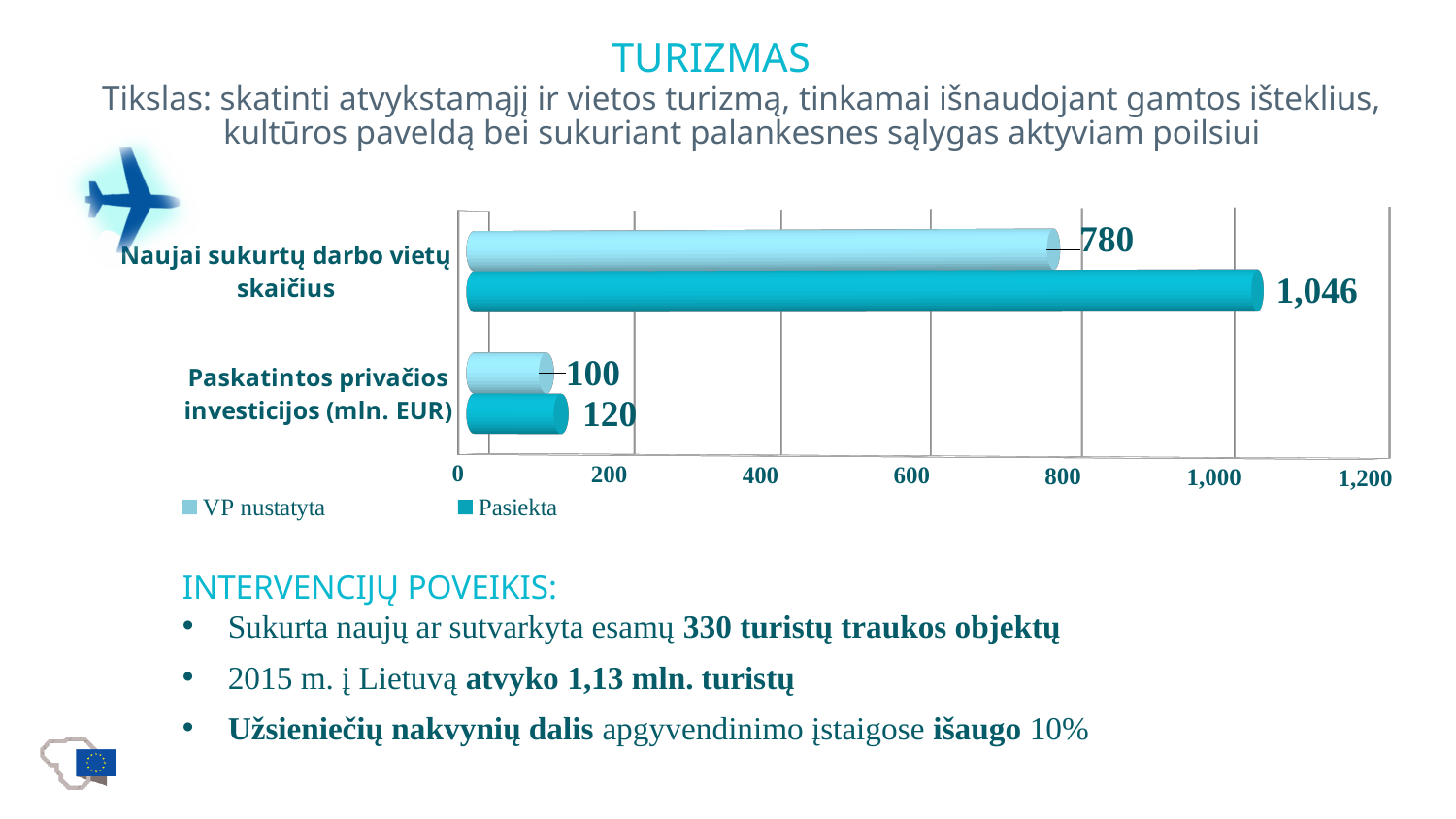
Which category has the highest 'Pasiekta' value? Naujai sukurtų darbo vietų skaičius What is the 'VP nustatyta' value for 'Paskatintos privačios investicijos (mln. EUR)'? 100 What kind of chart is shown on the slide? Bar chart How many series does the chart legend list? 2 What is the difference between the 'Pasiekta' and 'VP nustatyta' values for 'Naujai sukurtų darbo vietų skaičius'? 266 What is the 'VP nustatyta' value for 'Naujai sukurtų darbo vietų skaičius'? 780 What is the difference between the 'Pasiekta' and 'VP nustatyta' values for 'Paskatintos privačios investicijos (mln. EUR)'? 20 What is the 'Pasiekta' value for 'Naujai sukurtų darbo vietų skaičius'? 1,046 Which is larger for 'Naujai sukurtų darbo vietų skaičius': 'VP nustatyta' or 'Pasiekta'? Pasiekta What is the 'Pasiekta' value for 'Paskatintos privačios investicijos (mln. EUR)'? 120 How many categories are shown on the chart? 2 Which category has the lowest 'VP nustatyta' value? Paskatintos privačios investicijos (mln. EUR)